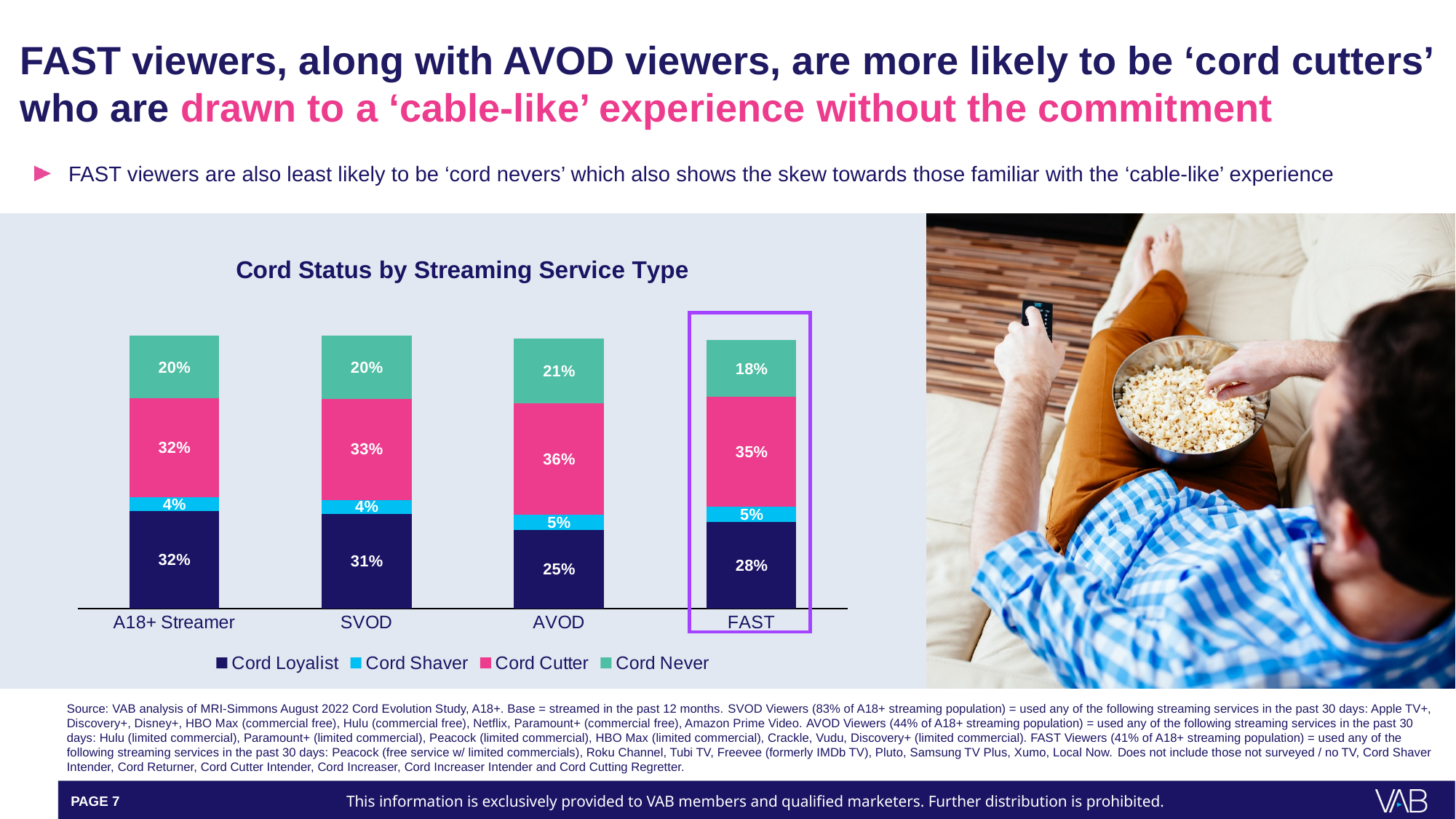
Which is larger: the Cord Cutter share for FAST or for SVOD? FAST What is the total of the stacked bar for FAST? 86% What is the title of the chart? Cord Status by Streaming Service Type What is the Cord Never share for FAST viewers? 18% What is the Cord Cutter share for AVOD viewers? 36% What is the difference between the Cord Loyalist share for A18+ Streamer and for AVOD? 7 percentage points Which category has the highest Cord Cutter share? AVOD Which category has the lowest Cord Never share? FAST How many series does the chart legend list? 4 How many streaming service type categories are shown on the x axis? 4 What type of chart is shown on the slide? Stacked bar chart What is the Cord Loyalist share for SVOD viewers? 31%